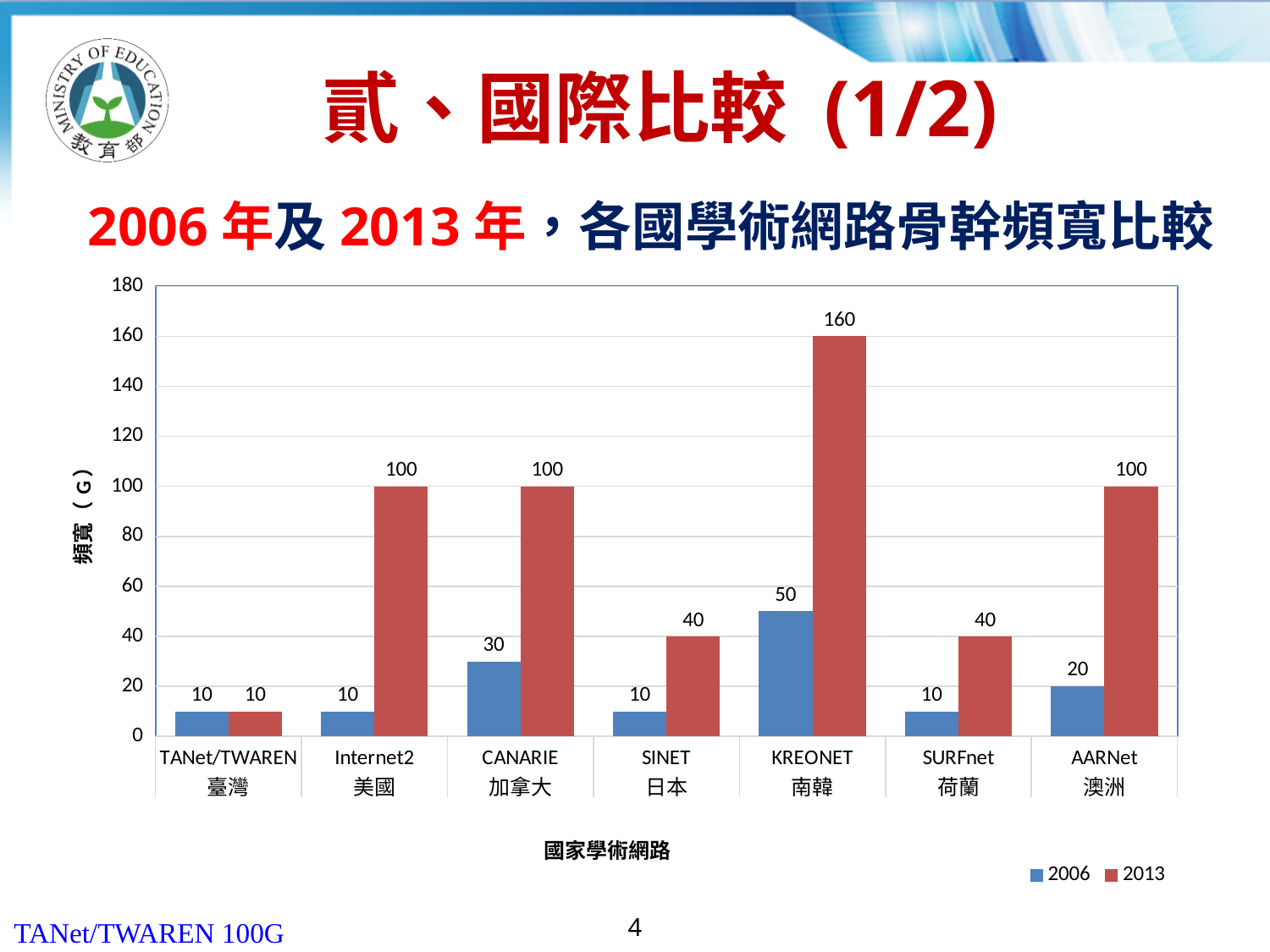
What type of chart is shown on the slide? Bar chart What is the 2013 value for SINET (日本)? 40 Which network has the highest 2013 value? KREONET (南韓) Which is larger: the 2013 value for SURFnet or the 2013 value for AARNet? AARNet How many series does the legend list? 2 What is the 2006 value for AARNet (澳洲)? 20 What is the difference between the 2013 and 2006 values for Internet2 (美國)? 90 How many networks (categories) are shown on the x axis? 7 What is the difference between the 2013 values for KREONET and CANARIE? 60 What is the 2013 value for KREONET (南韓)? 160 Which network has the highest 2006 value? KREONET (南韓) What is the 2006 value for CANARIE (加拿大)? 30